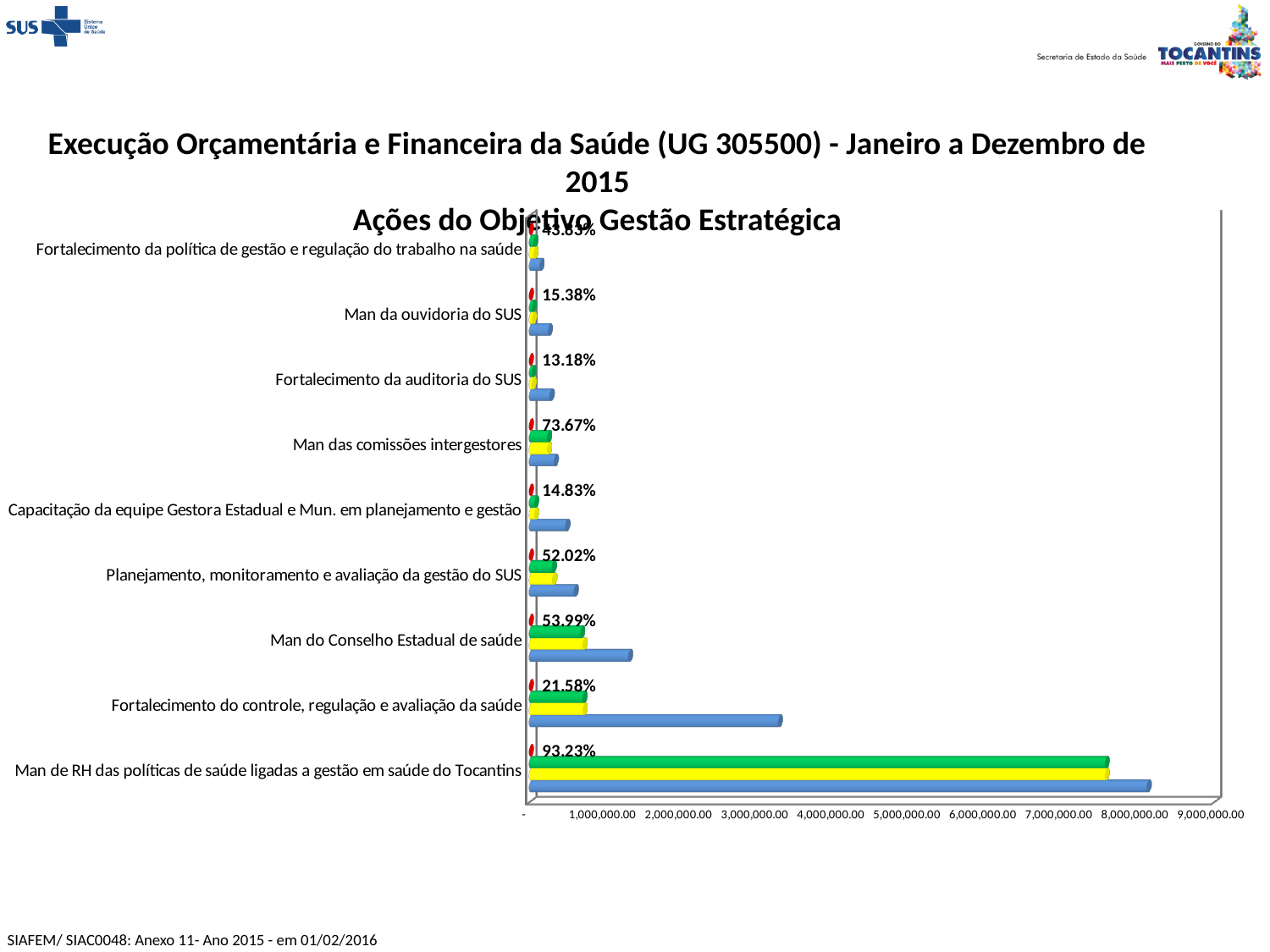
What percentage is shown for "Fortalecimento da auditoria do SUS"? 13.18% What percentage is shown for "Man de RH das políticas de saúde ligadas a gestão em saúde do Tocantins"? 93.23% What kind of chart is shown on the slide? Bar chart What percentage is shown for "Man das comissões intergestores"? 73.67% Is the blue bar for "Fortalecimento do controle, regulação e avaliação da saúde" greater or less than 3,000,000.00? greater Which has a higher percentage label: "Man do Conselho Estadual de saúde" or "Capacitação da equipe Gestora Estadual e Mun. em planejamento e gestão"? Man do Conselho Estadual de saúde Which category has the lowest percentage label? Fortalecimento da auditoria do SUS What percentage is shown for "Man da ouvidoria do SUS"? 15.38% Is the blue bar for "Man do Conselho Estadual de saúde" greater or less than 1,000,000.00? greater Which category has the highest percentage label? Man de RH das políticas de saúde ligadas a gestão em saúde do Tocantins How many categories (actions) are listed on the chart? 9 What percentage is shown for "Fortalecimento do controle, regulação e avaliação da saúde"? 21.58%